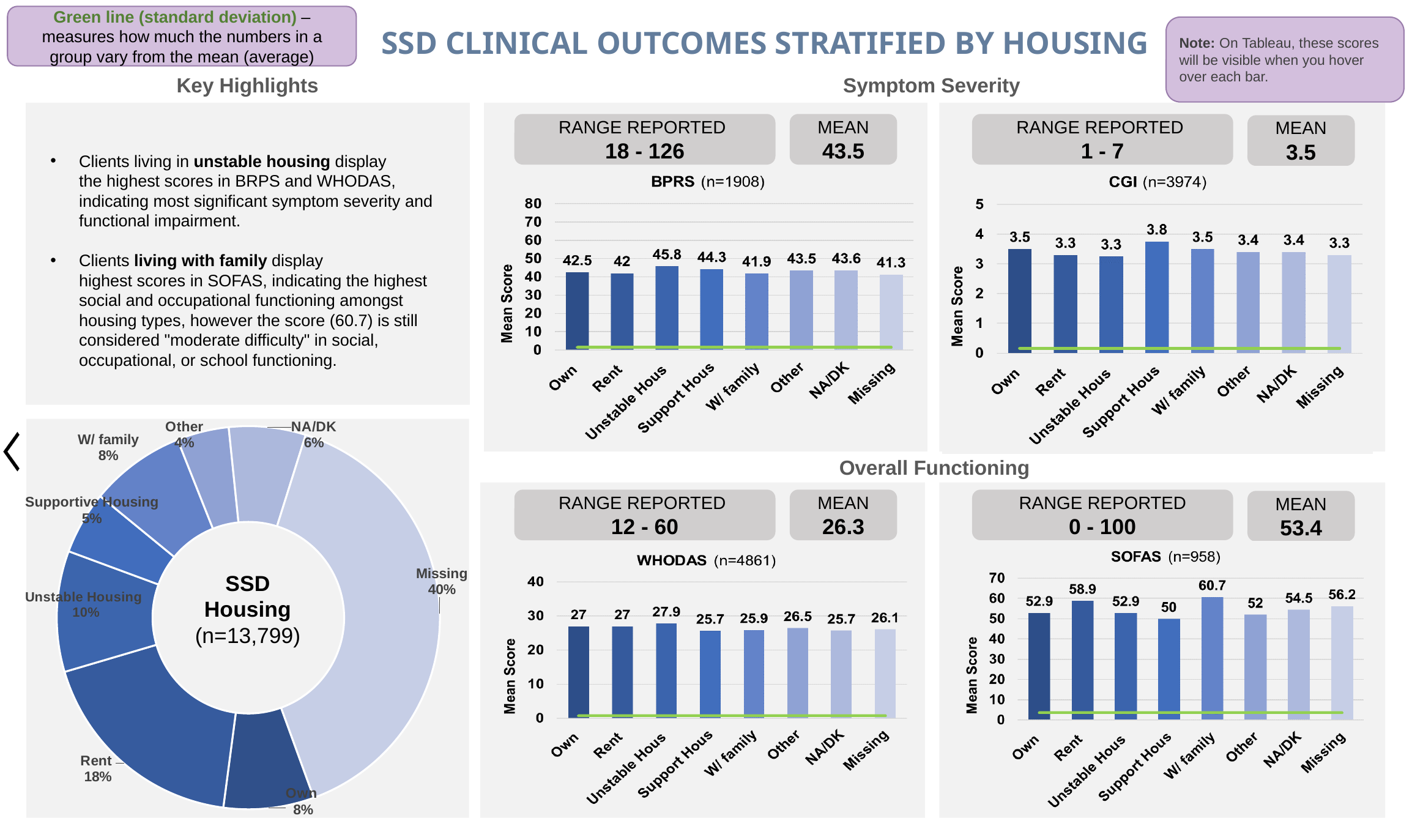
In the BPRS chart, what is the mean score for Unstable Hous? 45.8 In the SSD Housing donut chart, which category has the smallest share? Other In the BPRS chart, which housing category has the lowest mean score? Missing What kind of chart is the SSD Housing chart on the left of the slide? Donut (pie) chart In the SOFAS chart, which is larger, the mean score for Rent or for Support Hous? Rent In the WHODAS chart, how many housing categories are shown on the x axis? 8 In the CGI chart, which housing category has the highest mean score? Support Hous In the SOFAS chart, what is the difference between the mean scores for W/ family and Support Hous? 10.7 In the SSD Housing donut chart, what share of clients is in the Missing category? 40% In the SOFAS chart, what is the mean score for W/ family? 60.7 In the CGI chart, what is the mean score for Own? 3.5 In the WHODAS chart, what is the difference between the mean scores for Unstable Hous and Support Hous? 2.2